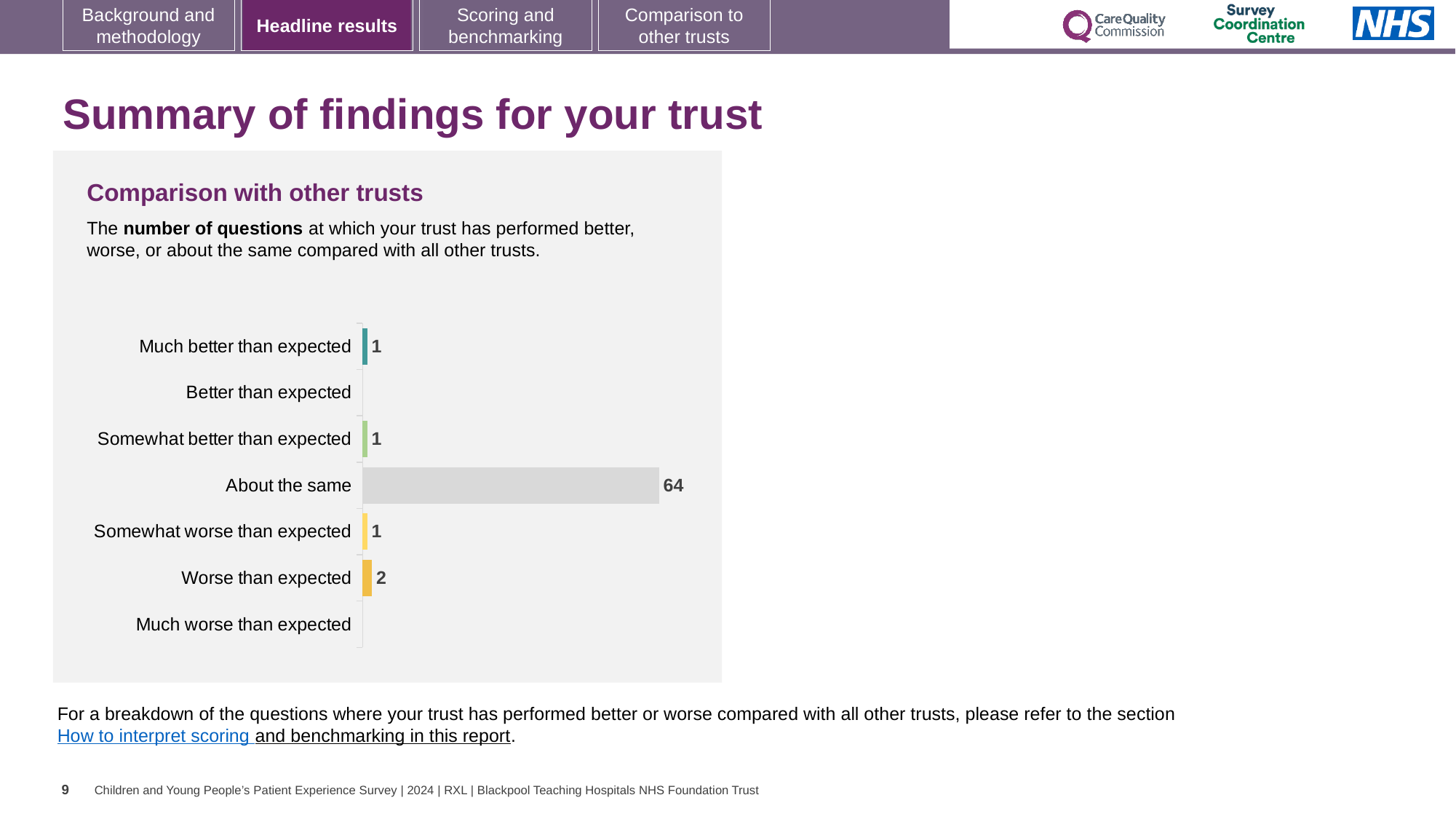
Which category has the highest number of questions? About the same How many categories are listed on the chart's axis? 7 Which is larger, the value for 'Worse than expected' or the value for 'Somewhat worse than expected'? Worse than expected What is the difference between the values for 'About the same' and 'Worse than expected'? 62 What is the value for 'Somewhat worse than expected'? 1 What is the value for 'Much better than expected'? 1 How many questions were rated 'About the same'? 64 What is the total of the values for 'Much better than expected' and 'Somewhat better than expected'? 2 What is the value for 'Worse than expected'? 2 What is the title of the chart section? Comparison with other trusts Which categories show no bar on the chart? Better than expected and Much worse than expected What kind of chart is shown on the slide? Bar chart